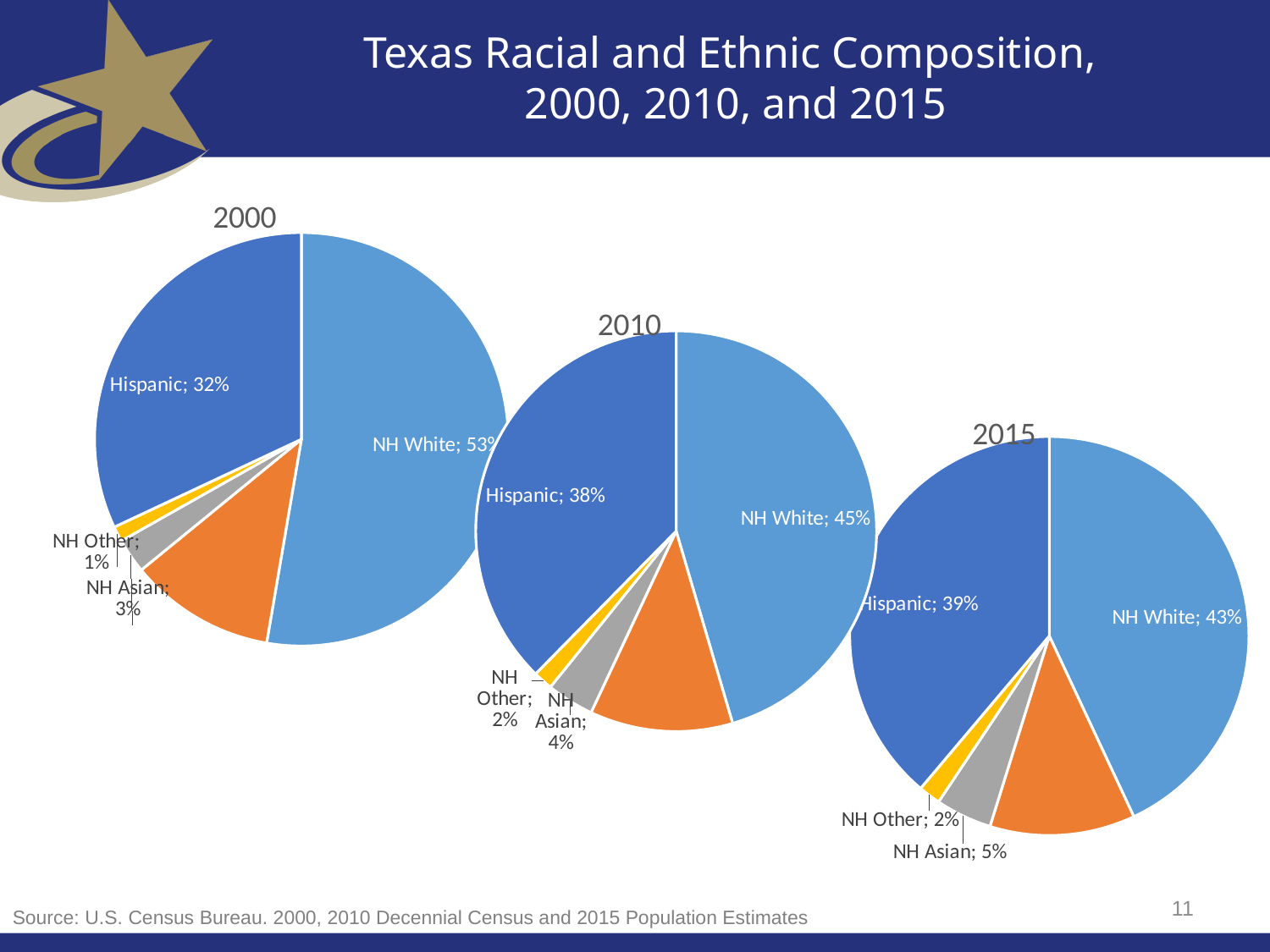
In the 2010 pie chart, which labeled category has the smallest share? NH Other In the 2015 pie chart, what share is labeled for NH Other? 2% What kind of charts are shown on the slide? Pie charts In the 2010 pie chart, what share is labeled for Hispanic? 38% In the 2015 pie chart, what share is labeled for NH Asian? 5% How many slices does the 2015 pie chart have? 5 In the 2000 pie chart, what is the difference between the NH White share and the Hispanic share? 21% In the 2000 pie chart, which labeled category has the largest share? NH White In the 2015 pie chart, what is the difference between the NH White share and the Hispanic share? 4% In the 2000 pie chart, what share is labeled for NH White? 53% What is the title of the slide? Texas Racial and Ethnic Composition, 2000, 2010, and 2015 In the 2010 pie chart, which is larger, the NH White share or the Hispanic share? NH White